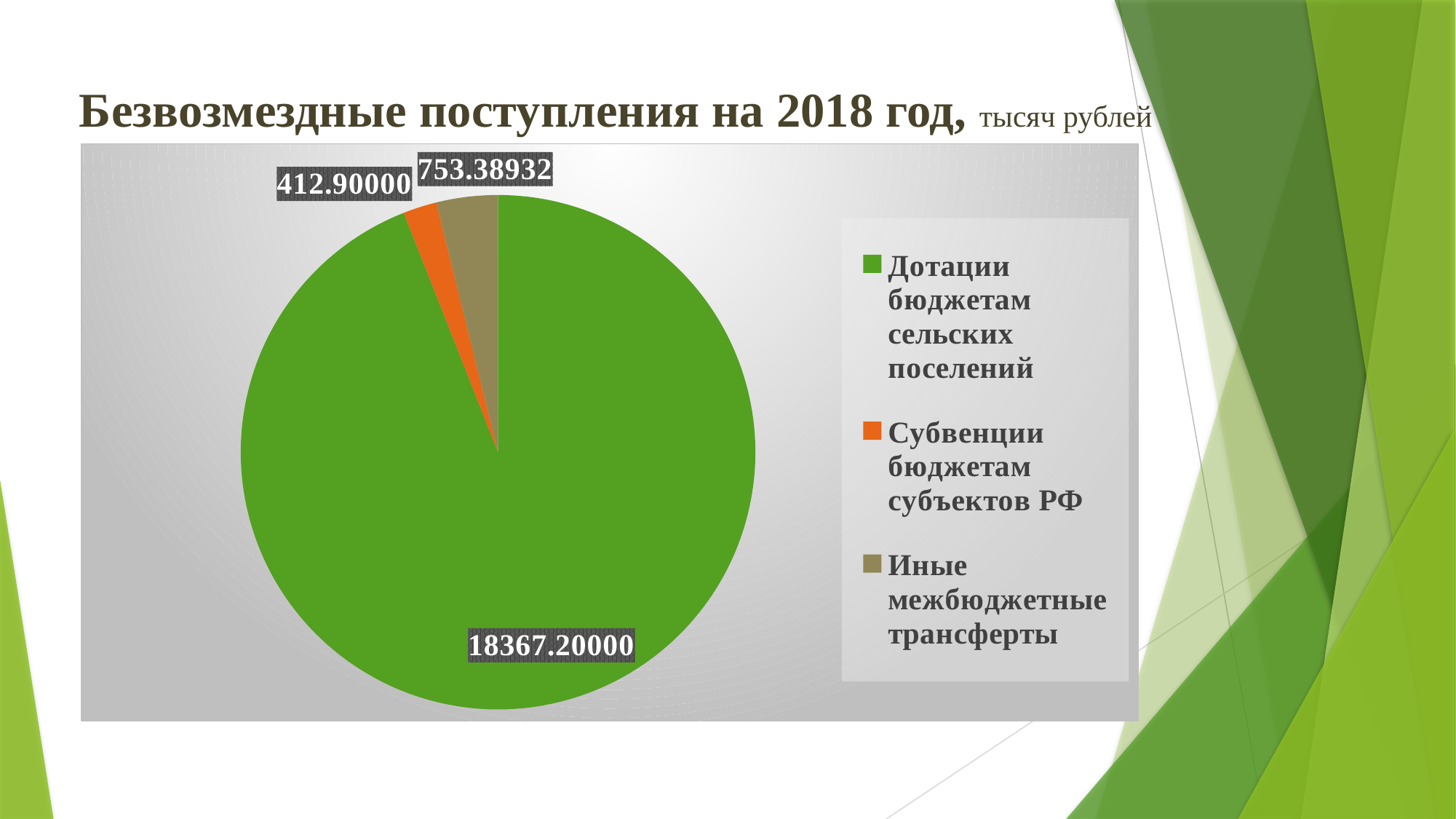
What is the value for Иные межбюджетные трансферты? 753.38932 How many slices does the pie chart have? 3 Which category has the largest slice of the pie? Дотации бюджетам сельских поселений What is the value for Дотации бюджетам сельских поселений? 18367.20000 What is the value for Субвенции бюджетам субъектов РФ? 412.90000 What is the difference between Иные межбюджетные трансферты and Субвенции бюджетам субъектов РФ? 340.48932 Which category has the smallest slice of the pie? Субвенции бюджетам субъектов РФ What is the difference between Дотации бюджетам сельских поселений and Иные межбюджетные трансферты? 17613.81068 What is the total of all three slices? 19533.48932 Which is larger: Иные межбюджетные трансферты or Субвенции бюджетам субъектов РФ? Иные межбюджетные трансферты What type of chart is shown on the slide? pie chart What colour is the slice for Субвенции бюджетам субъектов РФ? orange